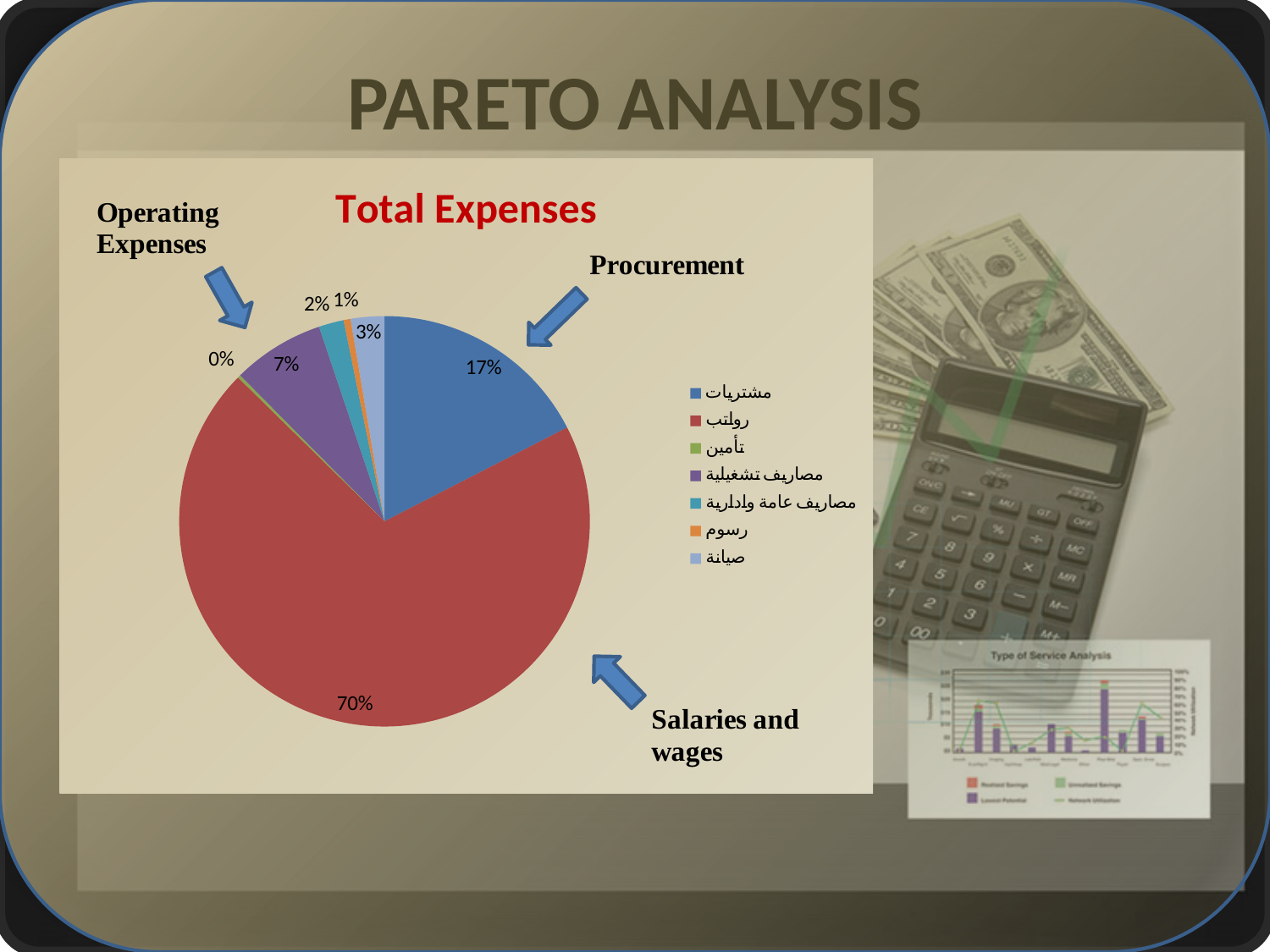
What colour is the slice representing Salaries and wages? Red Which category takes the largest share of the Total Expenses pie? Salaries and wages (رواتب) Which legend category has the smallest share of the pie, at 0%? تأمين By how many percentage points does the Salaries and wages share exceed the Procurement share? 53 percentage points How many categories does the legend of the Total Expenses pie chart list? 7 What share of the pie does the slice for صيانة (light blue) represent? 3% Which is larger: the Procurement share or the Operating Expenses share? Procurement What percentage of total expenses is labelled as Salaries and wages? 70% What is the title of the pie chart? Total Expenses What type of chart is shown under the title "Total Expenses"? Pie chart What percentage of total expenses is labelled as Procurement? 17% What percentage of total expenses is labelled as Operating Expenses? 7%